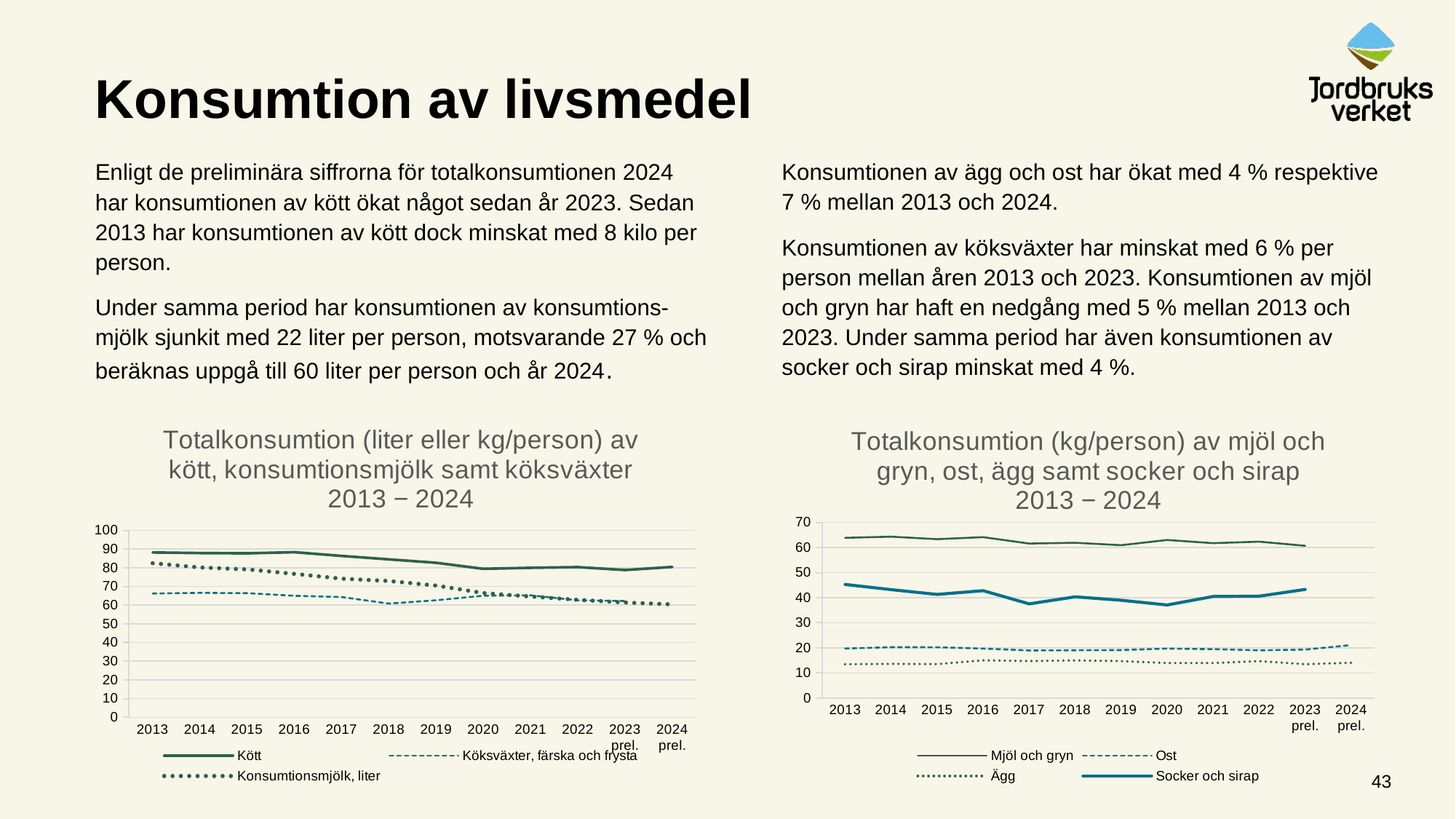
How many series does the legend of the left chart list? 3 How many years are shown on the x axis of the left chart? 12 How many series does the legend of the right chart, 'Totalkonsumtion (kg/person) av mjöl och gryn, ost, ägg samt socker och sirap 2013 − 2024', list? 4 In the left chart, is the value for Kött in 2013 greater or less than 80? greater In the right chart, is the value for Ägg in 2020 greater or less than 20? less In the left chart, does the value for Konsumtionsmjölk, liter rise or fall from 2013 to 2024? Fall In the left chart, is the value for Konsumtionsmjölk, liter in 2024 greater or less than 70? less In the right chart, which series has the lowest values across the whole period? Ägg In the left chart, which series has the highest value in 2013? Kött What kind of chart is the left chart, 'Totalkonsumtion (liter eller kg/person) av kött, konsumtionsmjölk samt köksväxter 2013 − 2024'? Line chart